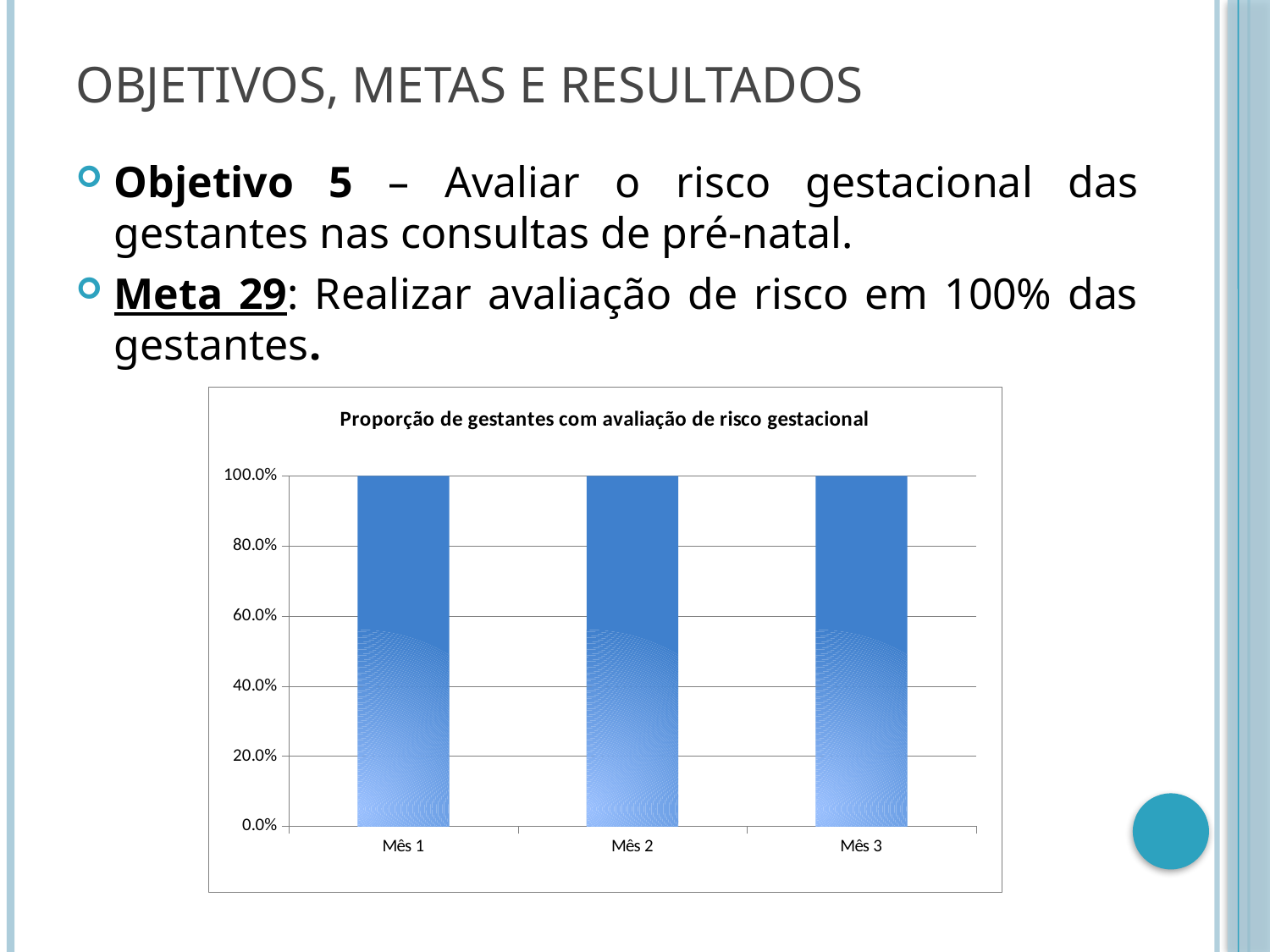
What is the value for Mês 3 in the chart? 100.0% What is the value for Mês 1 in the chart? 100.0% How many categories (months) are shown on the x axis of the chart? 3 What is the title of the chart? Proporção de gestantes com avaliação de risco gestacional What type of chart is shown on the slide? bar chart Do the values rise, fall, or stay the same from Mês 1 to Mês 3? stay the same Is the value for Mês 1 greater or less than 80.0%? greater What is the value for Mês 2 in the chart? 100.0% What is the highest value shown on the y axis of the chart? 100.0% What is the difference between the values for Mês 1 and Mês 2? 0.0% Is the value for Mês 3 greater or less than 60.0%? greater